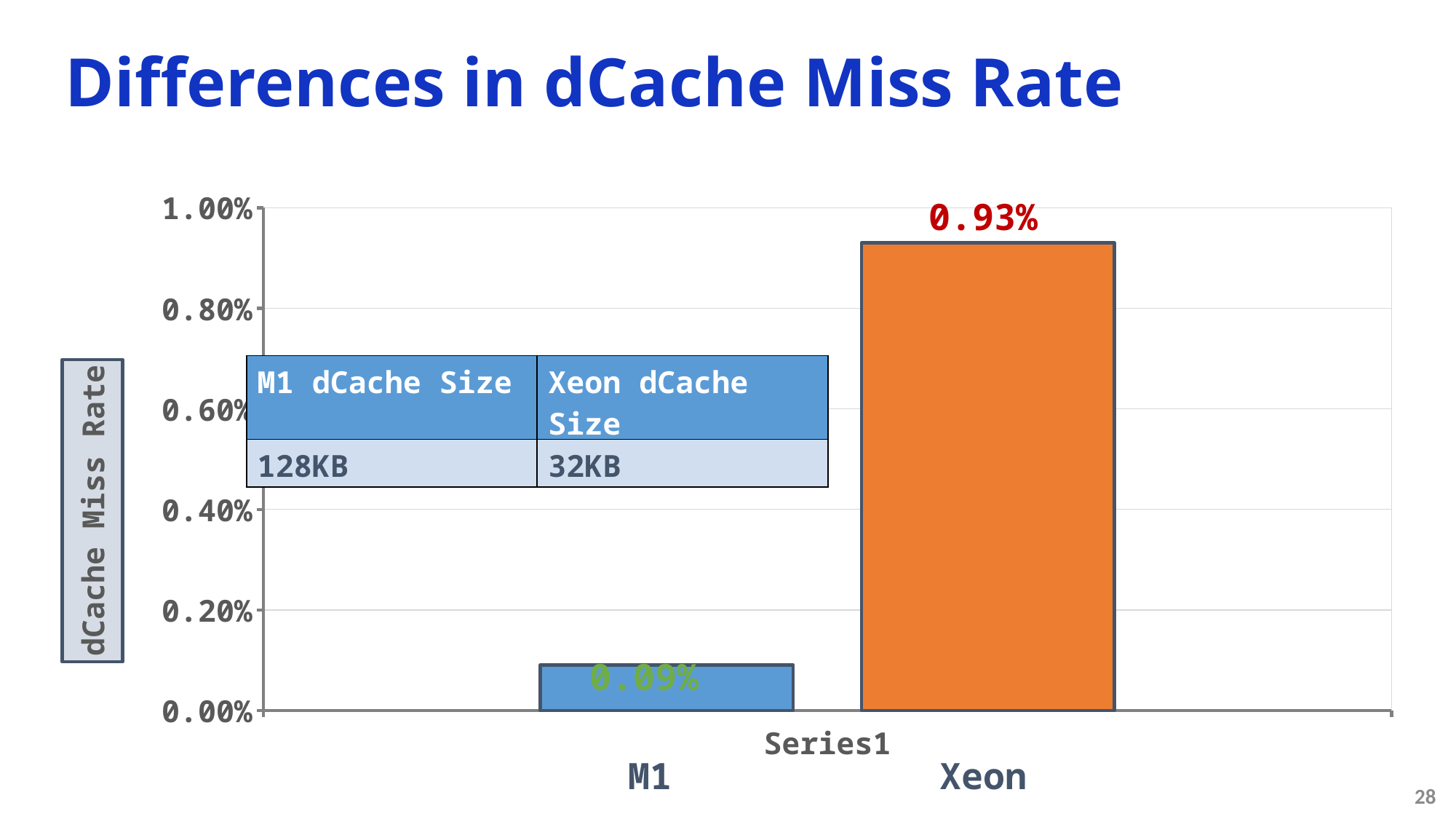
Which processor has the higher dCache miss rate? Xeon What colour is the bar for Xeon? Orange Which processor has the lower dCache miss rate? M1 What is the label on the vertical axis of the chart? dCache Miss Rate Is the dCache miss rate for M1 greater or less than 0.20%? less Is the dCache miss rate for Xeon greater or less than 0.80%? greater What kind of chart is shown on the slide? Bar chart How many bars are shown in the chart? 2 What is the difference between the Xeon and M1 dCache miss rates? 0.84% What is the dCache miss rate for M1? 0.09% What is the dCache miss rate for Xeon? 0.93% What is the title of the slide? Differences in dCache Miss Rate